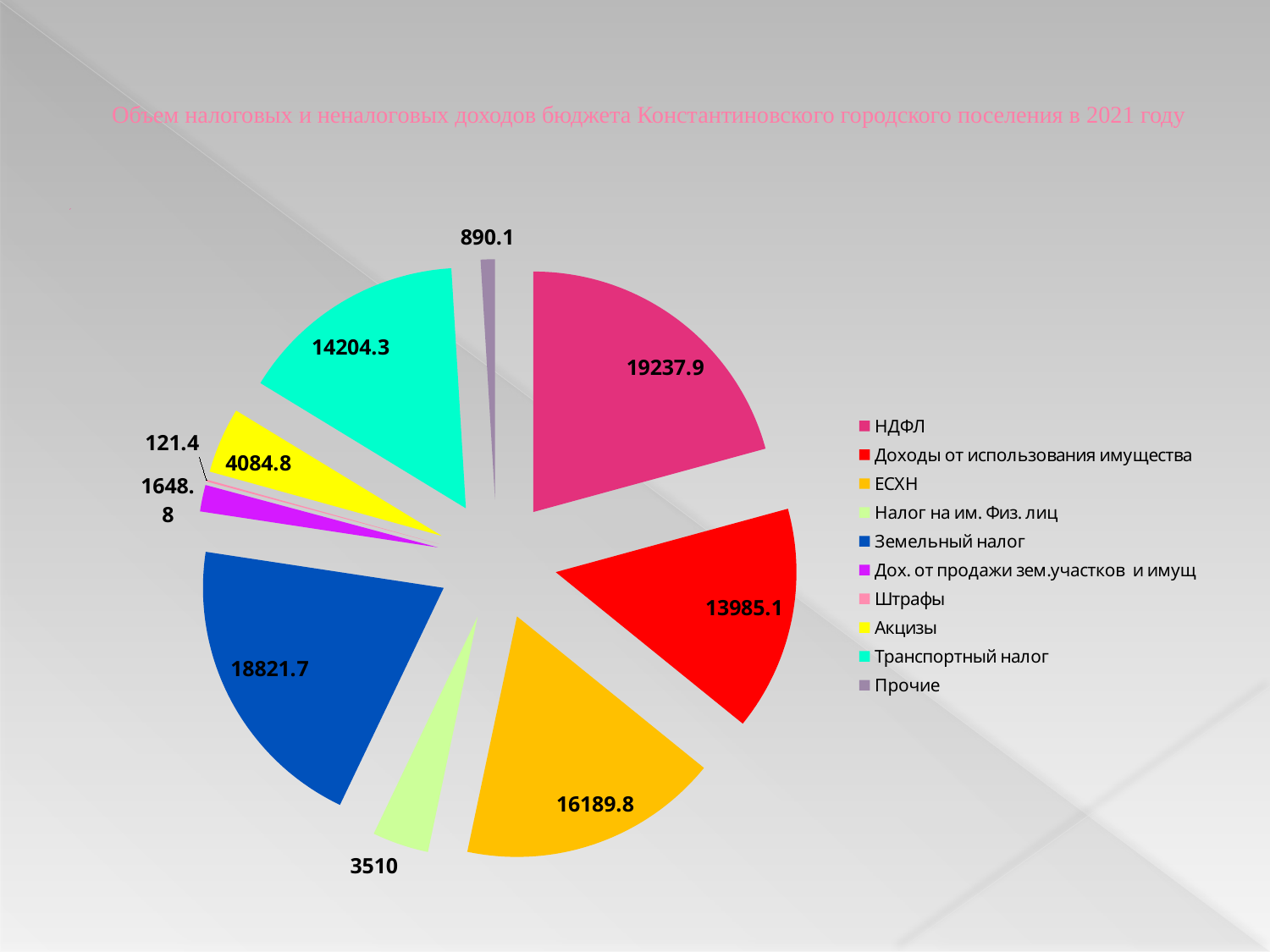
What is the value for Налог на им. Физ. лиц? 3510 What kind of chart is shown on the slide? pie chart What is the difference between ЕСХН and Доходы от использования имущества? 2204.7 What is the value for НДФЛ? 19237.9 What colour is the slice for Акцизы? yellow Which is larger, Акцизы or Транспортный налог? Транспортный налог Which category has the largest slice? НДФЛ What is the value for Земельный налог? 18821.7 What is the value for Штрафы? 121.4 What is the value for Транспортный налог? 14204.3 How many categories does the pie chart have? 10 Which category has the smallest slice? Штрафы